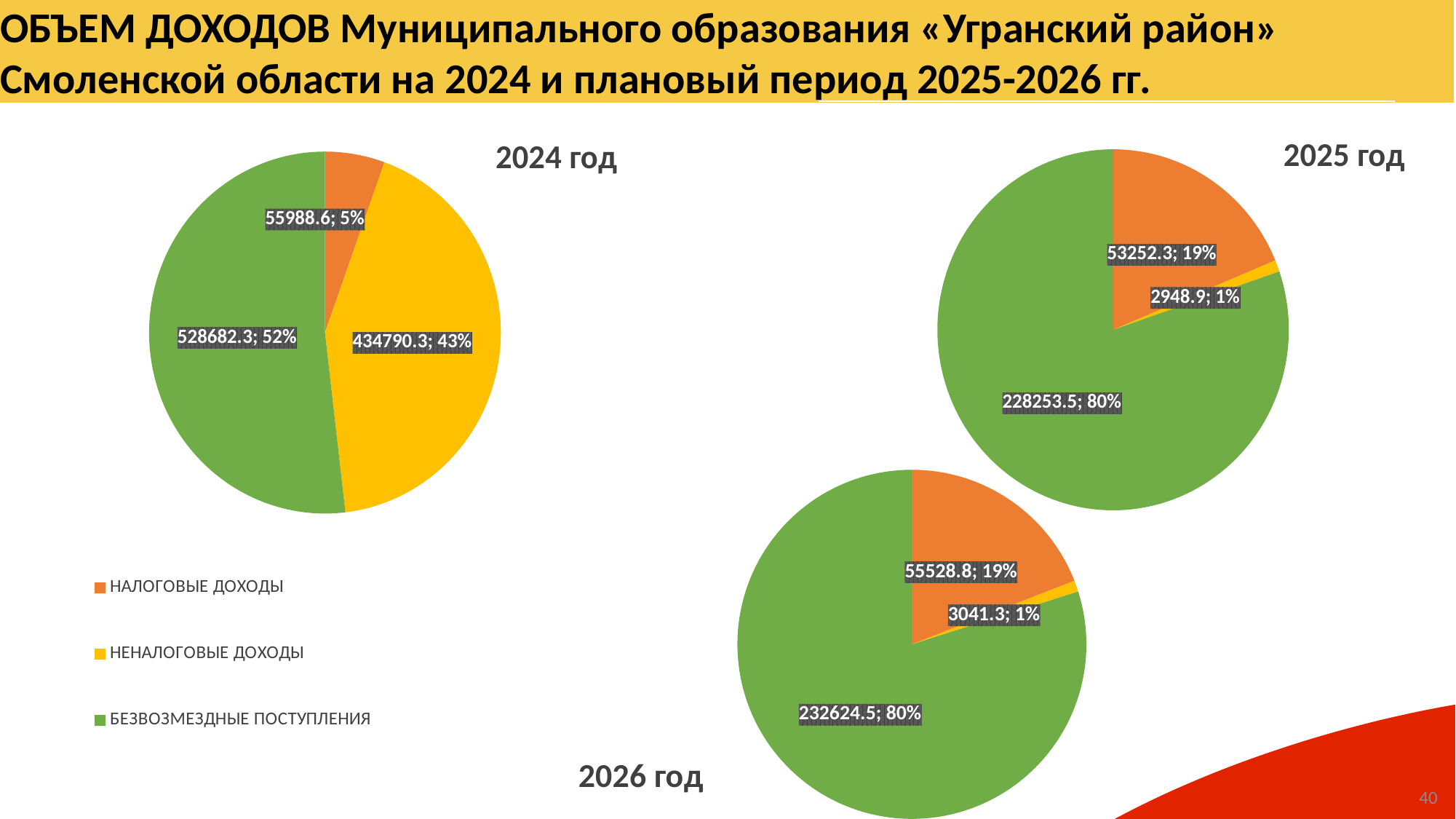
In the 2026 год pie chart, what value is shown for БЕЗВОЗМЕЗДНЫЕ ПОСТУПЛЕНИЯ? 232624.5 In the 2024 год pie chart, what value is shown for НЕНАЛОГОВЫЕ ДОХОДЫ? 434790.3 Which is larger in the 2024 год pie chart: НЕНАЛОГОВЫЕ ДОХОДЫ or НАЛОГОВЫЕ ДОХОДЫ? НЕНАЛОГОВЫЕ ДОХОДЫ In the 2026 год pie chart, what is the difference between the values for НАЛОГОВЫЕ ДОХОДЫ and НЕНАЛОГОВЫЕ ДОХОДЫ? 52487.5 In the 2025 год pie chart, which category has the largest slice? БЕЗВОЗМЕЗДНЫЕ ПОСТУПЛЕНИЯ In the 2024 год pie chart, what value is shown for НАЛОГОВЫЕ ДОХОДЫ? 55988.6 In the 2025 год pie chart, which category has the smallest slice? НЕНАЛОГОВЫЕ ДОХОДЫ How many categories does the legend list for the pie charts? 3 In the 2025 год pie chart, what value is shown for НАЛОГОВЫЕ ДОХОДЫ? 53252.3 In the 2024 год pie chart, what share of the pie is БЕЗВОЗМЕЗДНЫЕ ПОСТУПЛЕНИЯ? 52% In the 2026 год pie chart, what share of the pie is НАЛОГОВЫЕ ДОХОДЫ? 19% What type of chart is used for the 2025 год data? Pie chart